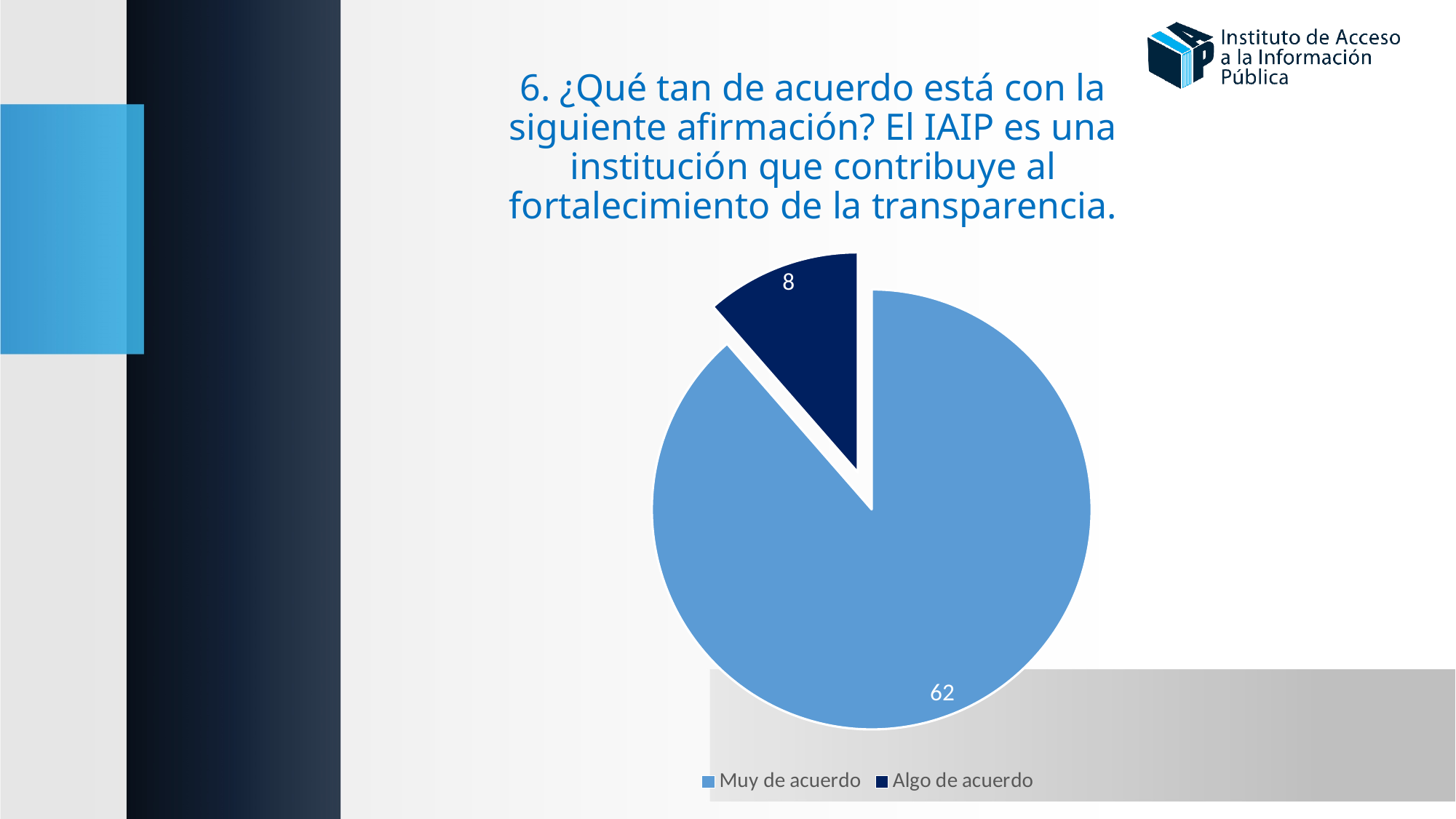
What colour is the "Algo de acuerdo" slice? dark navy blue Which category has the largest slice of the pie? Muy de acuerdo What is the value for "Muy de acuerdo"? 62 Which is larger, the value for "Muy de acuerdo" or the value for "Algo de acuerdo"? Muy de acuerdo What share of the total does the "Algo de acuerdo" slice represent? 8 out of 70 What is the value for "Algo de acuerdo"? 8 How many categories does the pie chart have? 2 What is the total of all slices in the pie chart? 70 What is the difference between the values for "Muy de acuerdo" and "Algo de acuerdo"? 54 What type of chart is shown on the slide? pie chart How many entries does the legend list? 2 Which category has the smallest slice of the pie? Algo de acuerdo